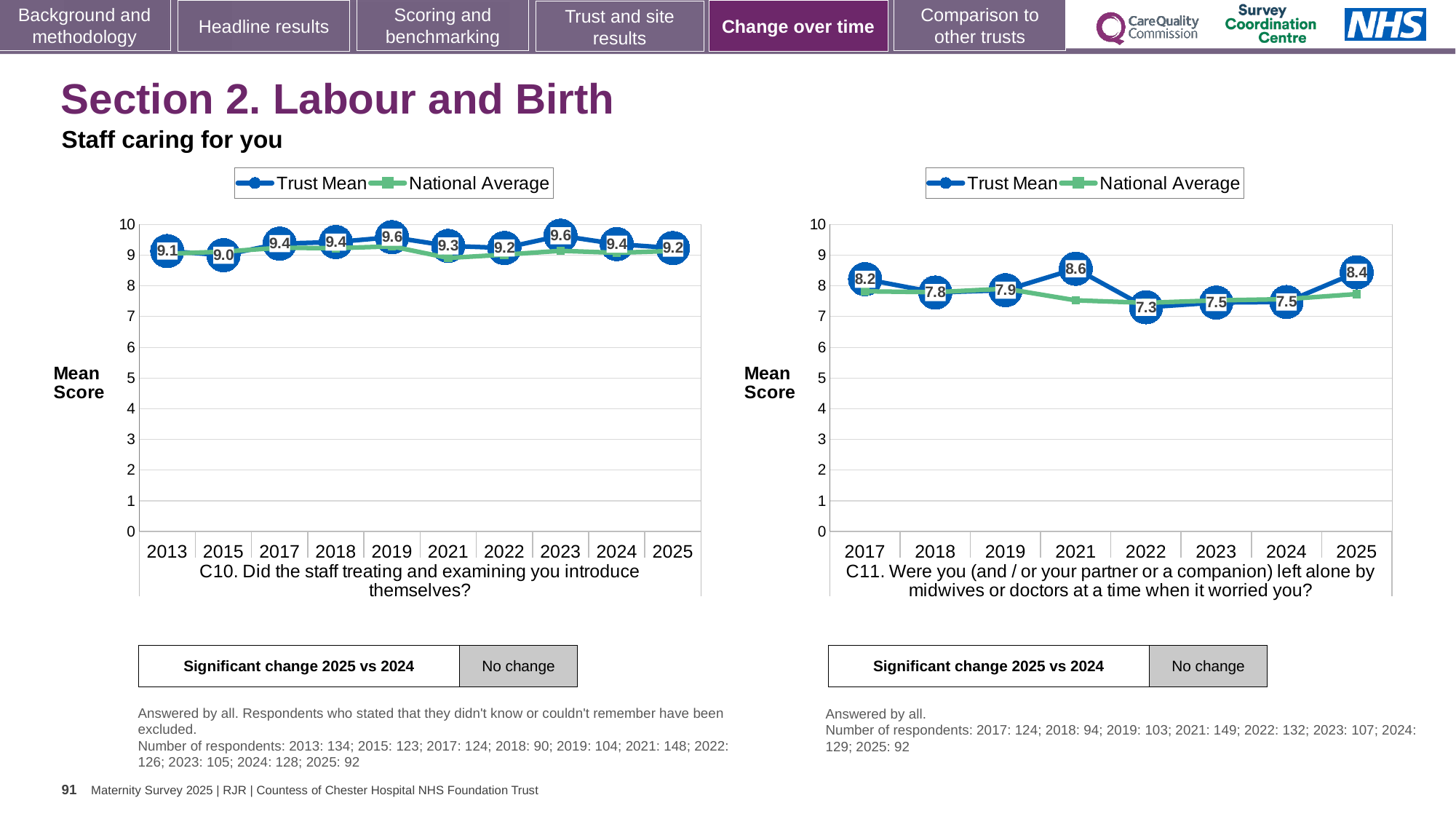
How many series does the legend of the right chart (C11) list? 2 On the right chart (C11), what is the difference between the Trust Mean scores for 2025 and 2022? 1.1 On the right chart (C11), which year has the highest Trust Mean score? 2021 On the right chart (C11), what is the Trust Mean score for 2021? 8.6 On the left chart (C10), which year has the lowest Trust Mean score? 2015 On the left chart (C10), what is the Trust Mean score for 2025? 9.2 On the left chart (C10), what is the difference between the Trust Mean scores for 2023 and 2025? 0.4 What kind of chart is the left chart (C10)? Line chart On the left chart (C10), how many years are shown on the x axis? 10 On the right chart (C11), which year has the lowest Trust Mean score? 2022 On the left chart (C10), what is the Trust Mean score for 2019? 9.6 On the right chart (C11), is the Trust Mean score for 2025 larger than the score for 2024? Yes